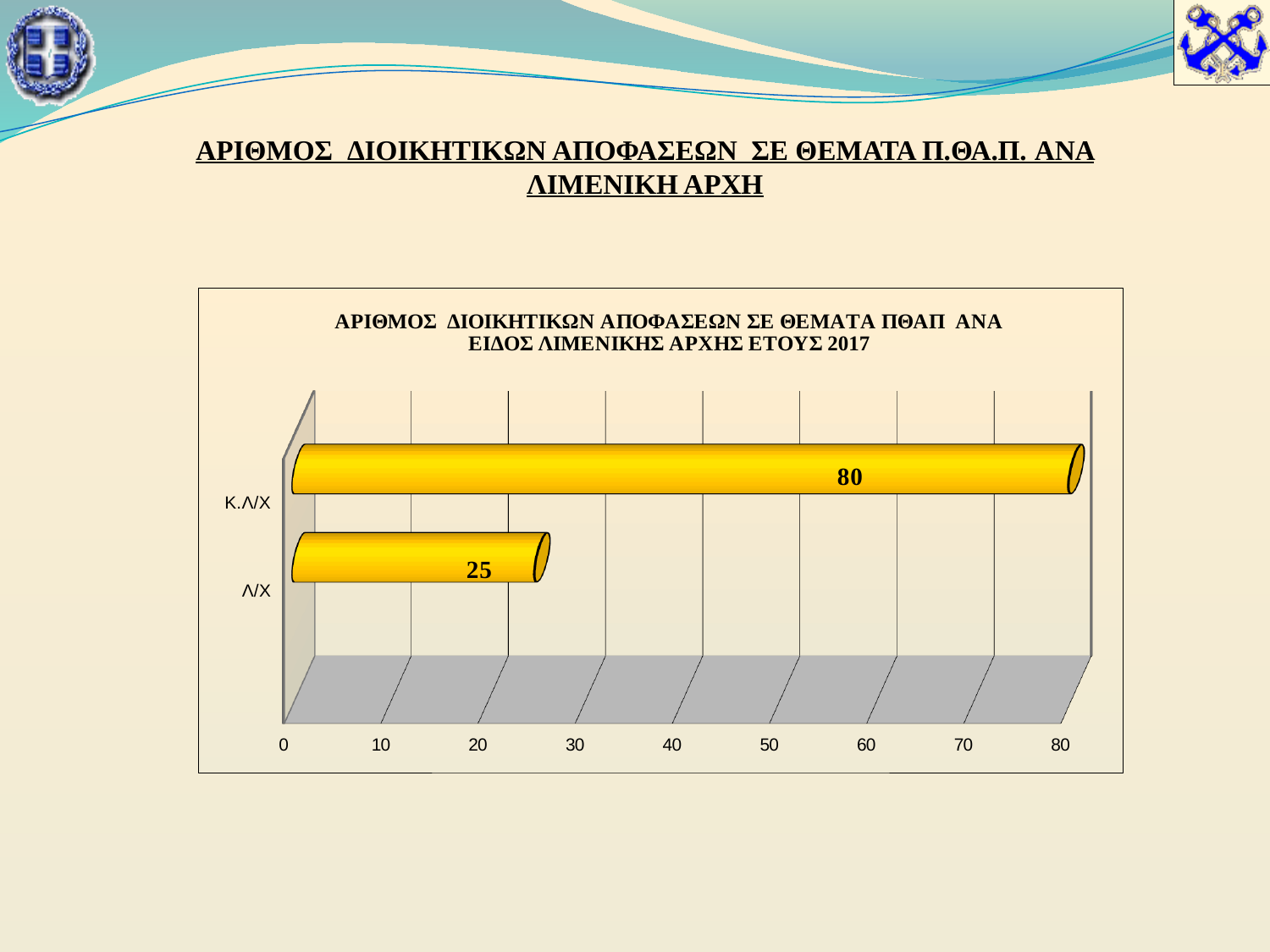
What kind of chart is shown on the slide? bar chart Which is larger, the value for Κ.Λ/Χ or the value for Λ/Χ? Κ.Λ/Χ What is the value for Κ.Λ/Χ? 80 What is the value for Λ/Χ? 25 What is the maximum value shown on the horizontal axis? 80 What is the difference between the values for Κ.Λ/Χ and Λ/Χ? 55 Which category has the highest value? Κ.Λ/Χ Which category has the lowest value? Λ/Χ What year is mentioned in the chart title? 2017 Is the value for Κ.Λ/Χ greater or less than 70? greater Is the value for Λ/Χ greater or less than 30? less How many categories are shown in the chart? 2